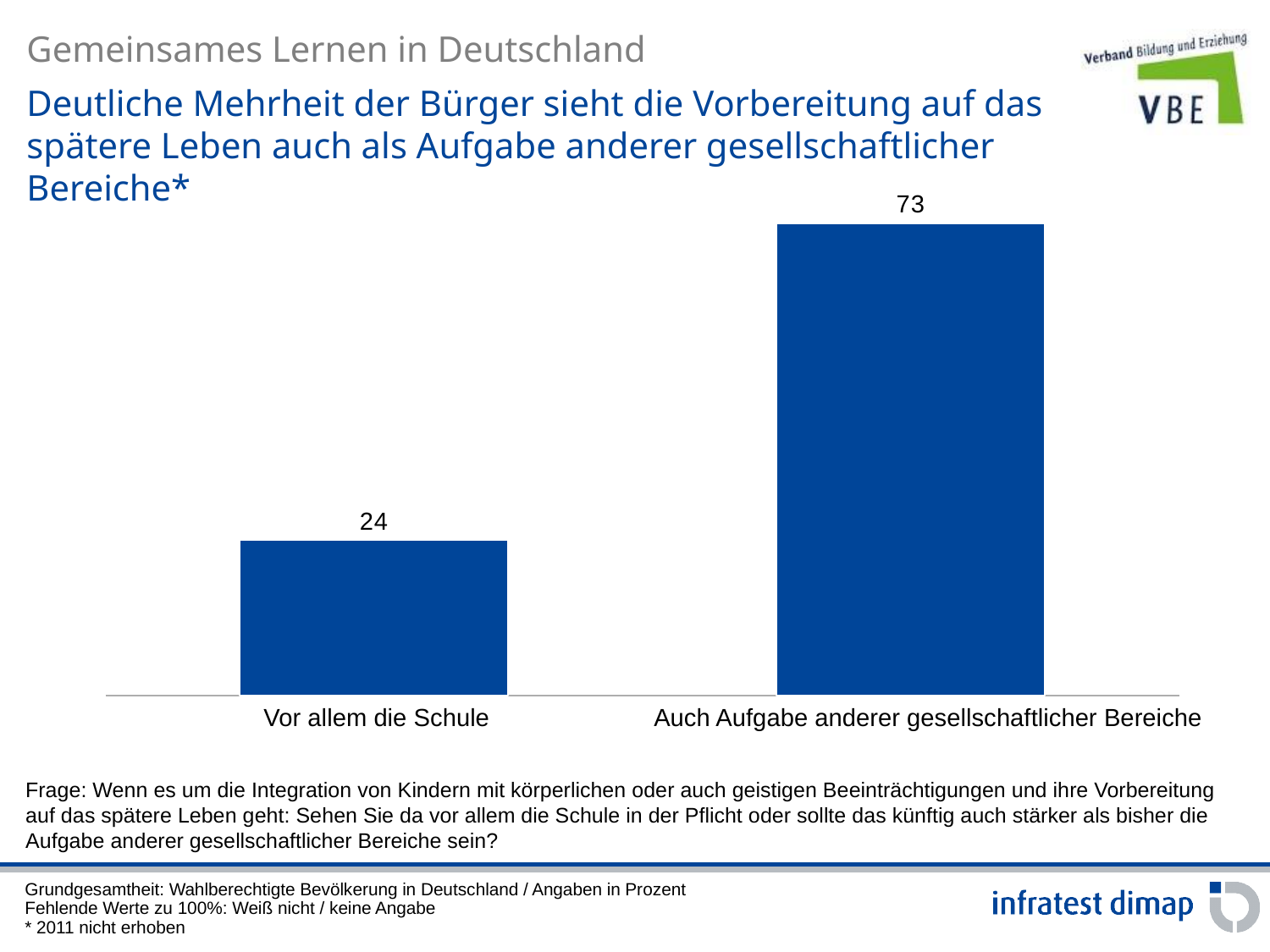
What is the value for "Auch Aufgabe anderer gesellschaftlicher Bereiche"? 73 What is the value for "Vor allem die Schule"? 24 In what unit are the values in the chart given, according to the footnote? Prozent What colour are the bars in the chart? Blue What is the difference between the values for "Auch Aufgabe anderer gesellschaftlicher Bereiche" and "Vor allem die Schule"? 49 How many categories are shown in the chart? 2 What is the sum of the two values shown in the chart? 97 Which category has the highest value? Auch Aufgabe anderer gesellschaftlicher Bereiche What kind of chart is shown on the slide? Bar chart Which category has the lowest value? Vor allem die Schule Which is larger: the value for "Vor allem die Schule" or for "Auch Aufgabe anderer gesellschaftlicher Bereiche"? Auch Aufgabe anderer gesellschaftlicher Bereiche